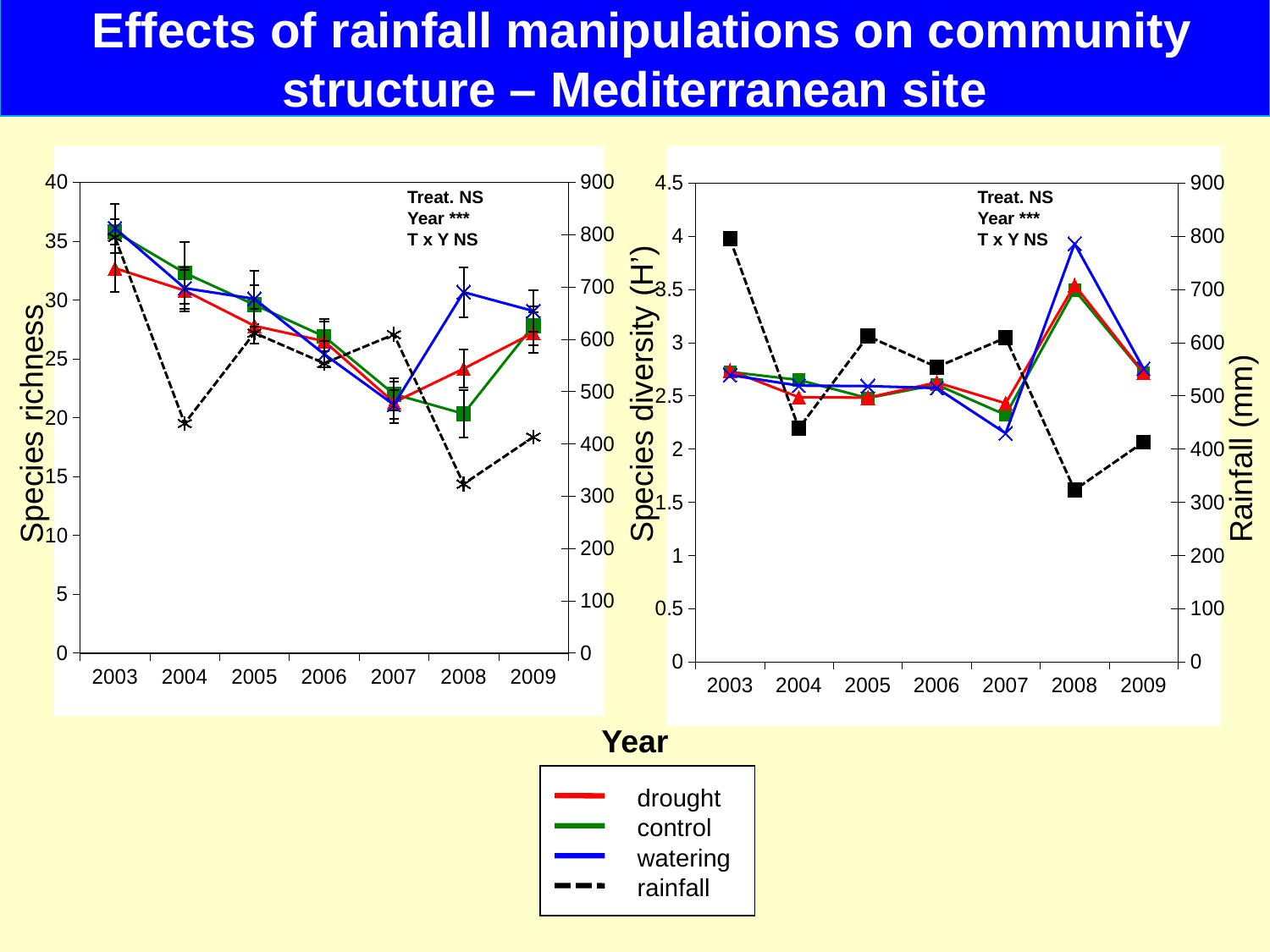
On the left chart (Species richness), how many years are plotted along the x axis? 7 On the left chart (Species richness), is the rainfall value for 2004 greater or less than 500? less How many series does the legend list? 4 What kind of chart is the left chart (Species richness)? line chart On the left chart (Species richness), in which year is rainfall lowest? 2008 On the left chart (Species richness), in which year is rainfall highest? 2003 On the left chart (Species richness), do the control values rise or fall from 2003 to 2007? fall On the left chart (Species richness), which is larger in 2008, the watering value or the control value? watering On the right chart (Species diversity), is the watering value for 2008 greater or less than 3.5? greater On the right chart (Species diversity), is the rainfall value for 2008 greater or less than 400? less What is the label of the right-hand y axis on the right chart? Rainfall (mm)